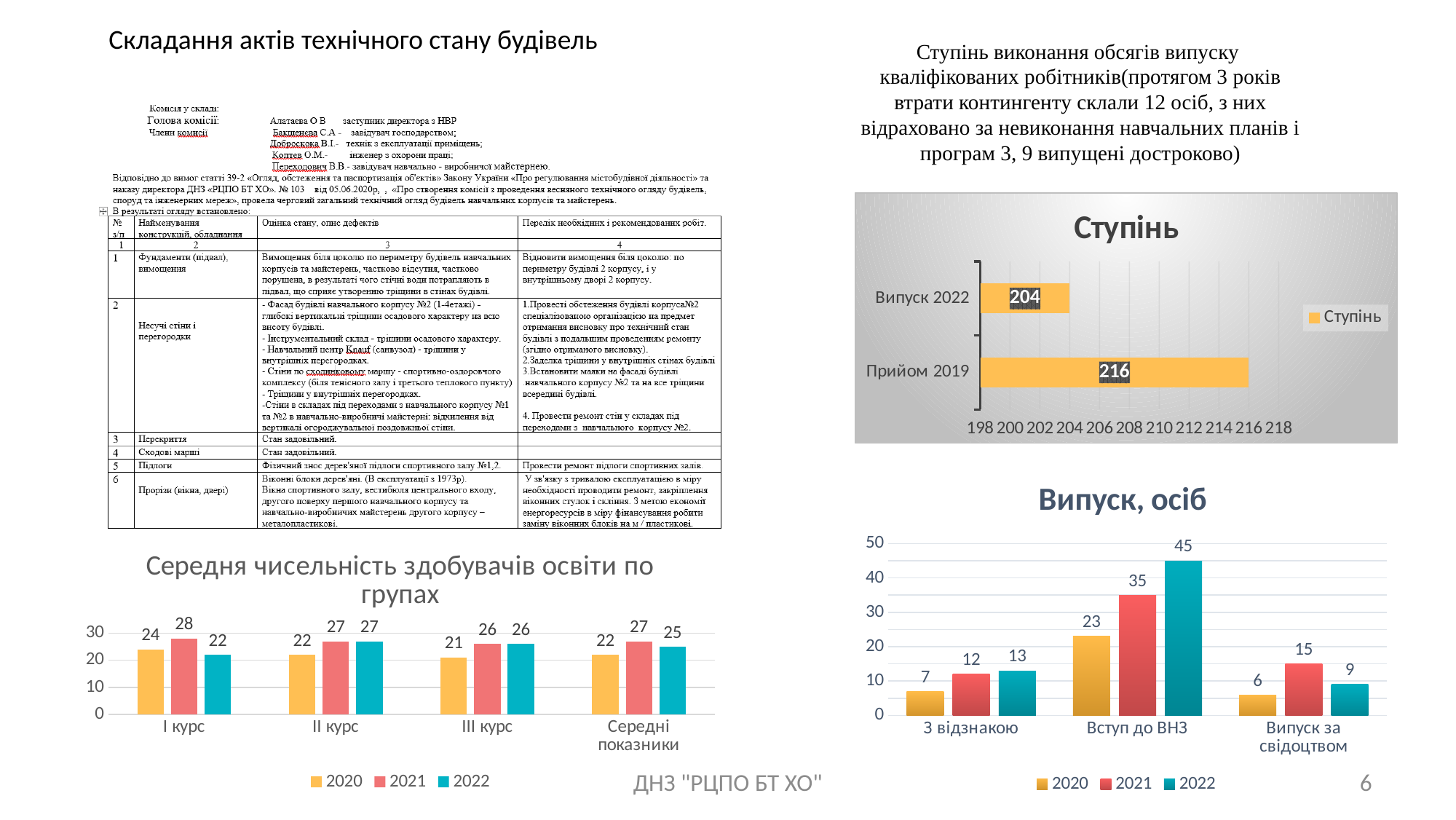
In the 'Середня чисельність здобувачів освіти по групах' chart, what is the 2020 value for ІІІ курс? 21 In the 'Середня чисельність здобувачів освіти по групах' chart, how many categories are shown on the x axis? 4 In the 'Випуск, осіб' chart, what is the difference between the 2021 and 2020 values for Випуск за свідоцтвом? 9 In the 'Ступінь' chart, what is the value for Прийом 2019? 216 In the 'Випуск, осіб' chart, which category has the highest 2021 value? Вступ до ВНЗ In the 'Ступінь' chart, what is the value for Випуск 2022? 204 In the 'Випуск, осіб' chart, what is the 2022 value for Вступ до ВНЗ? 45 What kind of chart is the 'Ступінь' chart? Bar chart In the 'Середня чисельність здобувачів освіти по групах' chart, how many series does the legend list? 3 In the 'Середня чисельність здобувачів освіти по групах' chart, what is the 2021 value for І курс? 28 In the 'Випуск, осіб' chart, which is larger for З відзнакою: the 2020 value or the 2022 value? 2022 In the 'Ступінь' chart, what is the difference between Прийом 2019 and Випуск 2022? 12